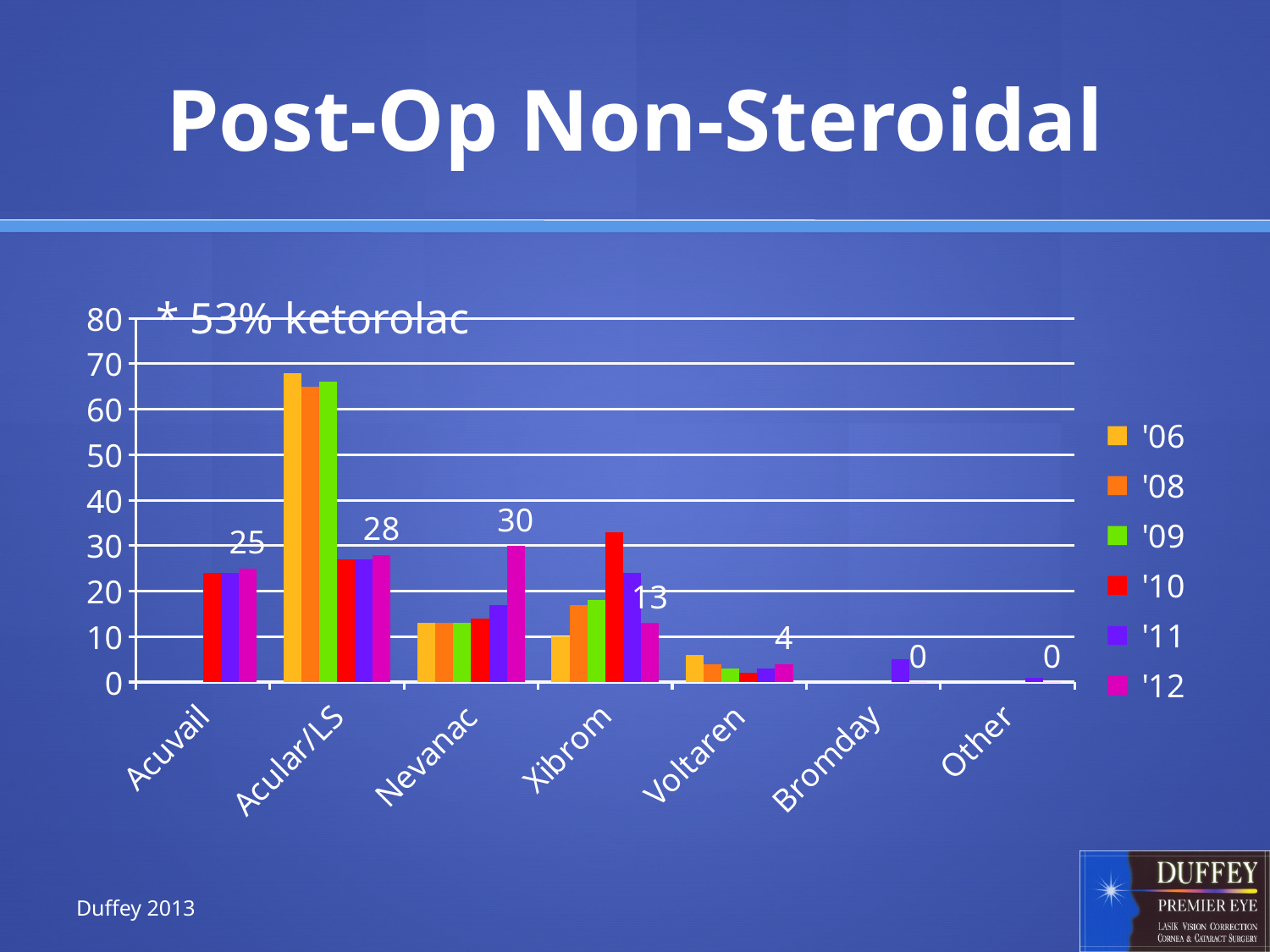
What is the value for Nevanac in the '12 series? 30 How many series does the legend list? 6 What is the value for Bromday in the '12 series? 0 How many categories are shown on the x axis? 7 What is the value for Acuvail in the '12 series? 25 What is the difference between the '12 values for Nevanac and Xibrom? 17 Which is larger in the '12 series: Acular/LS or Acuvail? Acular/LS What kind of chart is shown on the slide? bar chart Is the value for Acular/LS in the '06 series greater or less than 60? greater What is the value for Voltaren in the '12 series? 4 What is the title of the slide containing the chart? Post-Op Non-Steroidal Among the '12 series values, which category is the highest? Nevanac